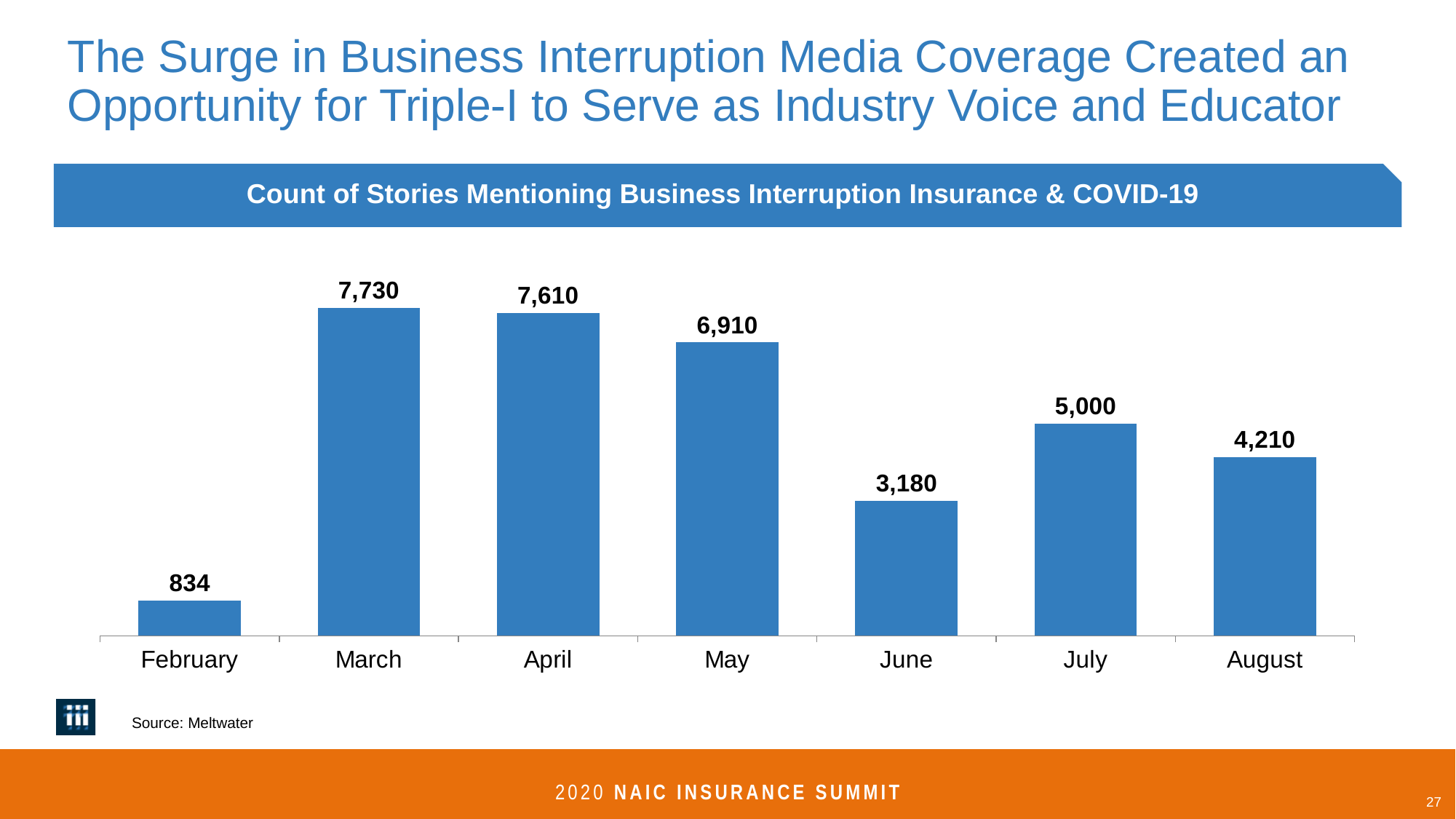
What is the difference between the counts for July and June? 1,820 What is the count of stories for June? 3,180 Do the counts rise or fall from March to June? Fall Which month has the lowest count of stories? February What is the count of stories for February? 834 How many months are shown on the chart? 7 What kind of chart is shown on the slide? Bar chart What is the difference between the counts for March and April? 120 What is the title of the chart? Count of Stories Mentioning Business Interruption Insurance & COVID-19 Which month has the highest count of stories? March What is the count of stories for March? 7,730 Which month has a higher count of stories, May or August? May